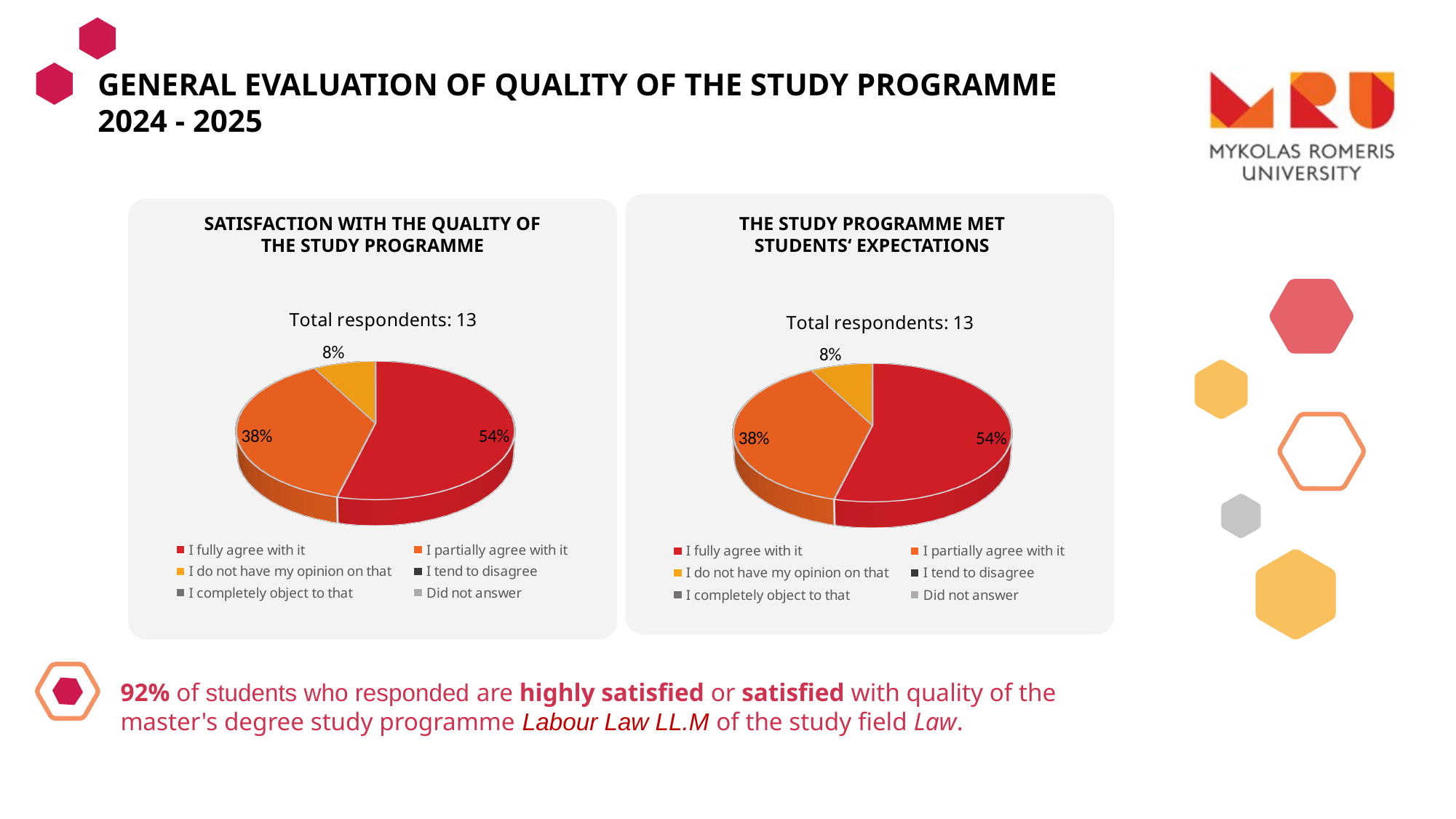
In the 'Satisfaction with the quality of the study programme' chart, what share of respondents chose 'I do not have my opinion on that'? 8% What type of chart is used in the 'Satisfaction with the quality of the study programme' panel? Pie chart How many total respondents are reported for the 'Satisfaction with the quality of the study programme' chart? 13 How many entries does the legend of the 'The study programme met students' expectations' chart list? 6 In the 'The study programme met students' expectations' chart, what share of respondents chose 'I fully agree with it'? 54% In the 'Satisfaction with the quality of the study programme' chart, what is the difference in percentage points between 'I fully agree with it' and 'I partially agree with it'? 16 In the 'Satisfaction with the quality of the study programme' chart, which response has the largest share? I fully agree with it In the 'The study programme met students' expectations' chart, which response has the smallest share among the plotted slices? I do not have my opinion on that In the 'Satisfaction with the quality of the study programme' chart, what share of respondents chose 'I partially agree with it'? 38% In the 'Satisfaction with the quality of the study programme' chart, what share of respondents chose 'I fully agree with it'? 54% In the 'The study programme met students' expectations' chart, which is larger: 'I partially agree with it' or 'I do not have my opinion on that'? I partially agree with it In the 'The study programme met students' expectations' chart, what share of respondents chose 'I do not have my opinion on that'? 8%